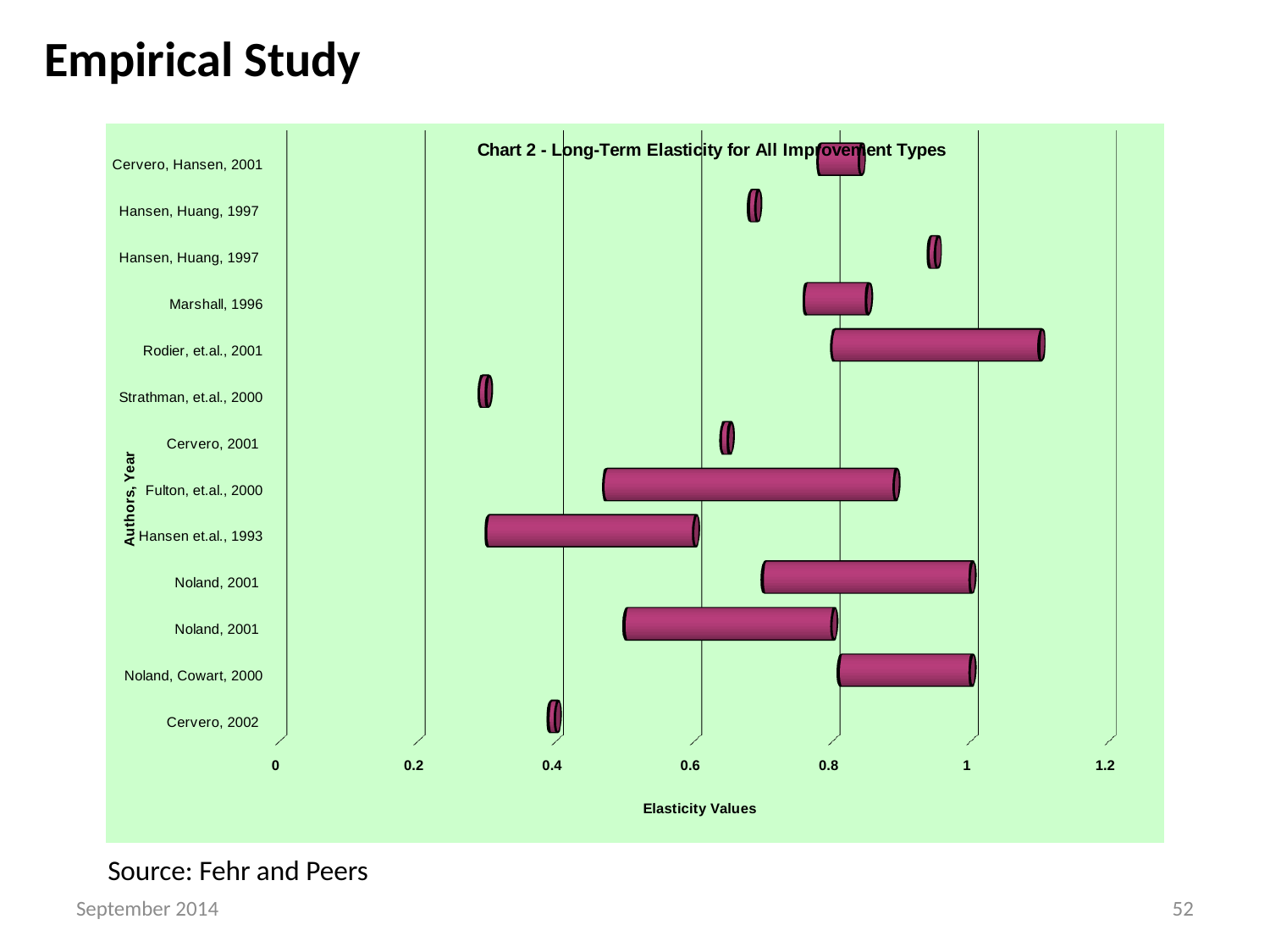
Is the elasticity value for Cervero, Hansen, 2001 greater or less than 0.6? greater What is the label of the horizontal axis? Elasticity Values Which bar reaches a higher elasticity value, Rodier, et.al., 2001 or Marshall, 1996? Rodier, et.al., 2001 Is the elasticity value for Cervero, 2001 greater or less than 0.6? greater At what elasticity value does the bar for Cervero, 2002 sit? 0.4 Is the upper end of the bar for Rodier, et.al., 2001 greater or less than 1? greater What kind of chart is shown on the slide? bar chart What is the title of the chart? Chart 2 - Long-Term Elasticity for All Improvement Types Which category's bar reaches the highest elasticity value? Rodier, et.al., 2001 How many author/year categories are listed on the vertical axis? 13 What is the upper end of the elasticity range for Hansen et.al., 1993? 0.6